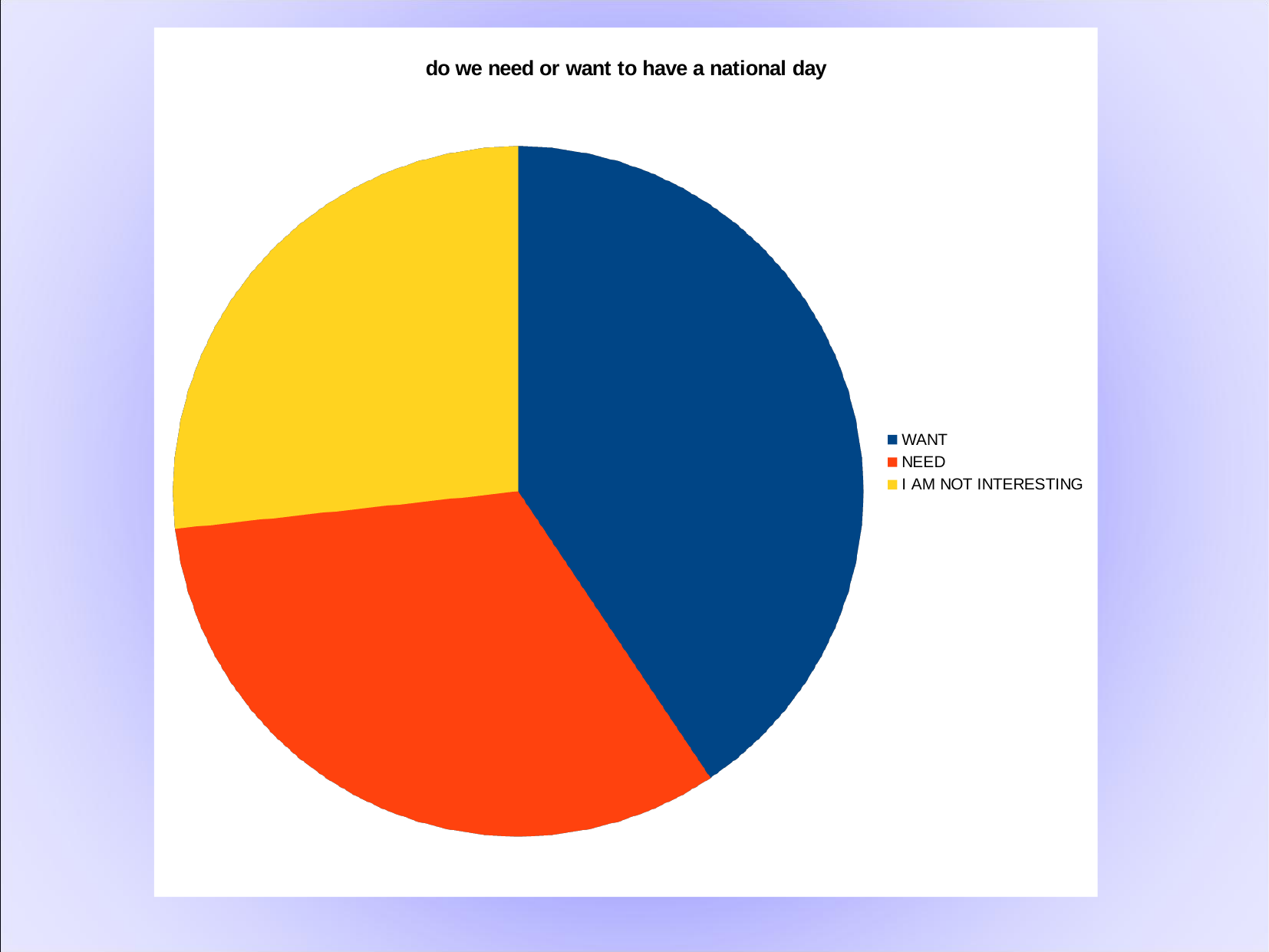
How many slices does the pie chart have? 3 How many entries does the legend list? 3 Which category has the smallest slice of the pie? I AM NOT INTERESTING Which slice is larger, WANT or NEED? WANT Which slice is larger, WANT or I AM NOT INTERESTING? WANT What is the title of the chart? do we need or want to have a national day What kind of chart is shown on the slide? pie chart What colour is the WANT slice? blue Which category has the largest slice of the pie? WANT